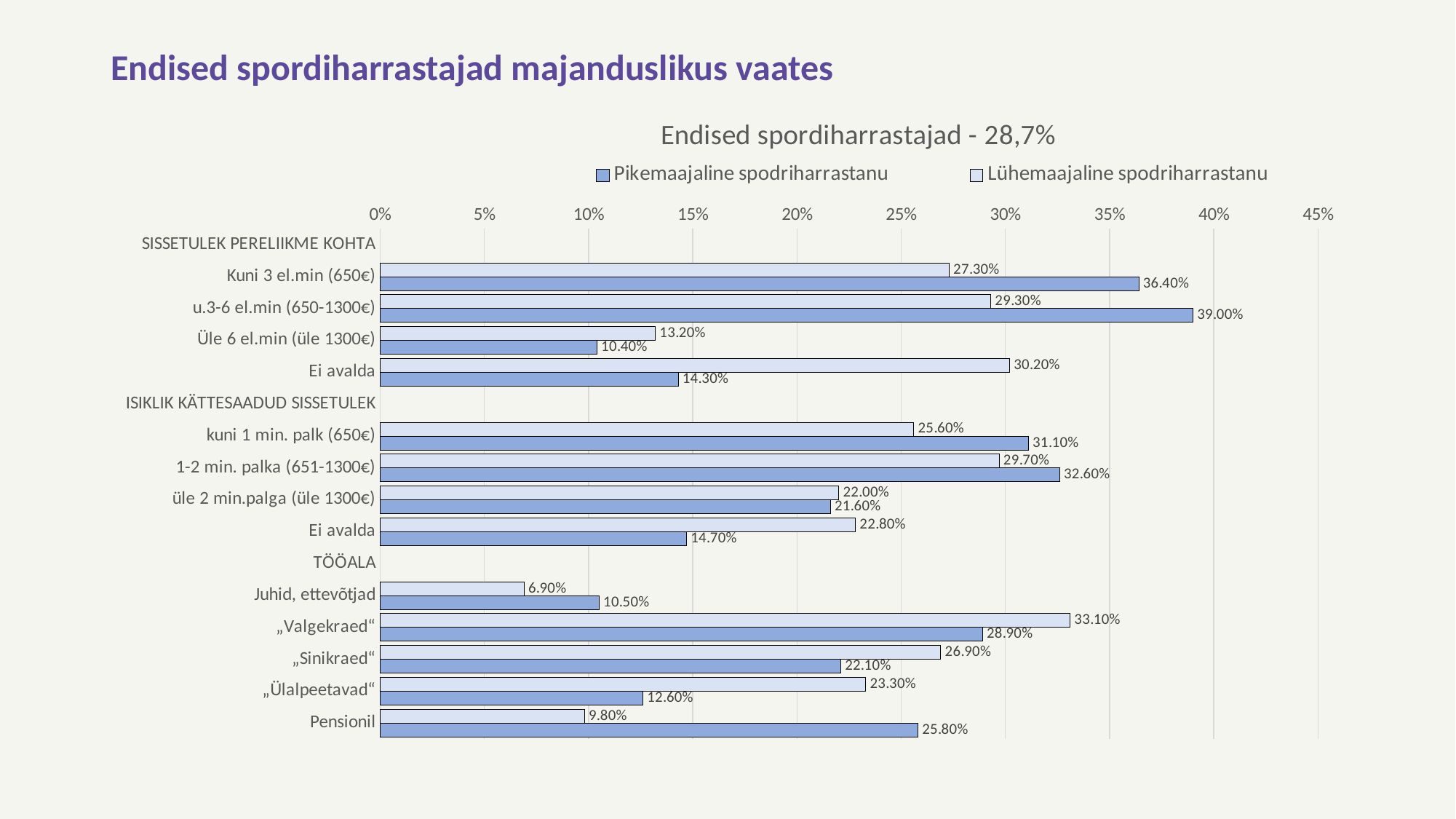
For „Ülalpeetavad“, which series has the larger value, Pikemaajaline spodriharrastanu or Lühemaajaline spodriharrastanu? Lühemaajaline spodriharrastanu What is the difference between the Pikemaajaline and Lühemaajaline values for Pensionil? 16.00% How many series does the legend list? 2 Which category has the lowest value for Lühemaajaline spodriharrastanu? Juhid, ettevõtjad What is the difference between the Pikemaajaline and Lühemaajaline values for Kuni 3 el.min (650€)? 9.10% What type of chart is shown on the slide? bar chart Which category has the lowest value for Pikemaajaline spodriharrastanu? Üle 6 el.min (üle 1300€) What is the value for Lühemaajaline spodriharrastanu in the category „Valgekraed“? 33.10% Which category has the highest value for Pikemaajaline spodriharrastanu? u.3-6 el.min (650-1300€) What is the value for Pikemaajaline spodriharrastanu in the category Pensionil? 25.80% What is the value for Pikemaajaline spodriharrastanu in the category u.3-6 el.min (650-1300€)? 39.00% What percentage is shown in the chart title? 28,7%